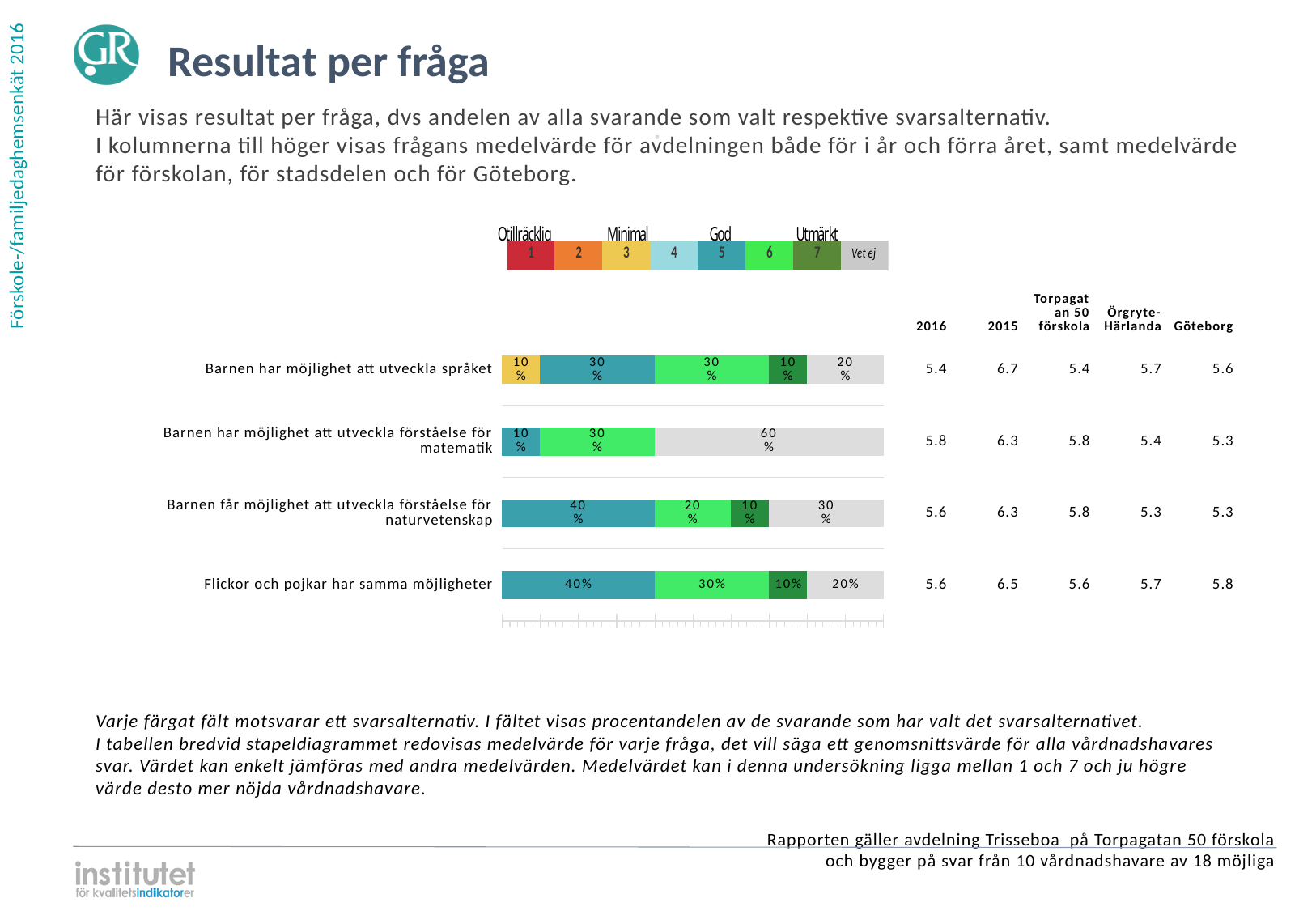
Which question has the largest 'Vet ej' share? Barnen har möjlighet att utveckla förståelse för matematik What are the four scale labels shown above the legend? Otillräcklig, Minimal, God, Utmärkt What is the difference between the 'Vet ej' share for 'Barnen har möjlighet att utveckla förståelse för matematik' and for 'Flickor och pojkar har samma möjligheter'? 40% What percentage of respondents answered 'Vet ej' for 'Barnen har möjlighet att utveckla förståelse för matematik'? 60% What is the 2016 mean value for 'Barnen har möjlighet att utveckla förståelse för matematik'? 5.8 What percentage of respondents chose answer 7 (dark green segment) for 'Barnen får möjlighet att utveckla förståelse för naturvetenskap'? 10% What is the Göteborg mean value for 'Flickor och pojkar har samma möjligheter'? 5.8 What percentage of respondents chose answer 5 (teal segment) for 'Flickor och pojkar har samma möjligheter'? 40% What is the 2015 mean value for 'Barnen har möjlighet att utveckla språket'? 6.7 What kind of chart is shown on the slide? Stacked bar chart Which is larger: the answer 6 (light green) share for 'Barnen har möjlighet att utveckla språket' or for 'Barnen får möjlighet att utveckla förståelse för naturvetenskap'? Barnen har möjlighet att utveckla språket How many questions (categories) are plotted in the bar chart? 4